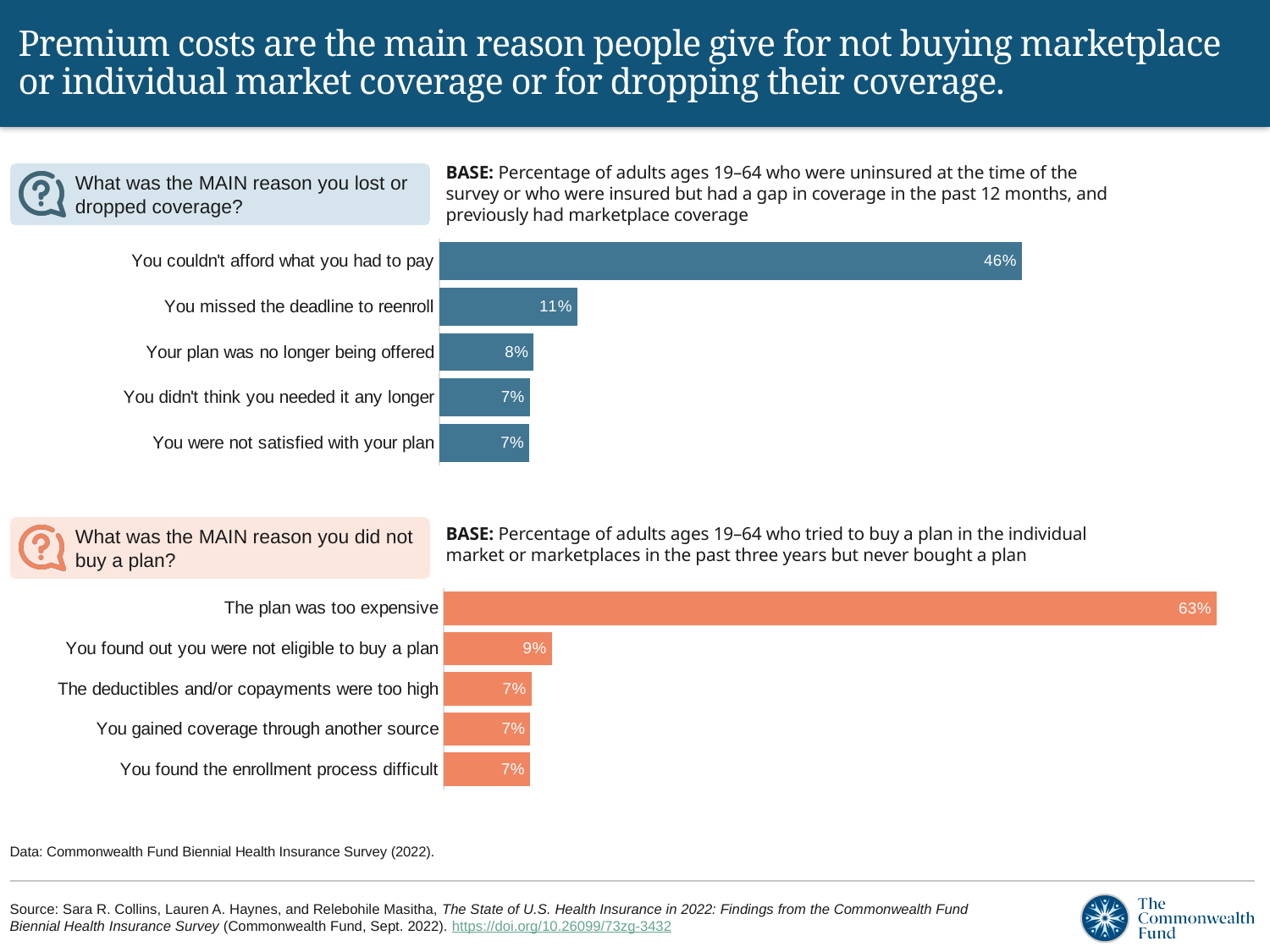
In the top chart (main reason you lost or dropped coverage), how many reasons are listed? 5 In the bottom chart (main reason you did not buy a plan), what percentage said they found out they were not eligible to buy a plan? 9% In the top chart (main reason you lost or dropped coverage), what is the difference between 'You couldn't afford what you had to pay' and 'You missed the deadline to reenroll'? 35 percentage points In the bottom chart (main reason you did not buy a plan), what is the difference between 'The plan was too expensive' and 'You found out you were not eligible to buy a plan'? 54 percentage points What type of chart is used on this slide? Bar chart In the top chart (main reason you lost or dropped coverage), what percentage said they missed the deadline to reenroll? 11% In the top chart (main reason you lost or dropped coverage), what percentage said they couldn't afford what they had to pay? 46% In the bottom chart (main reason you did not buy a plan), what percentage said the plan was too expensive? 63% In the top chart (main reason you lost or dropped coverage), which reason has the highest percentage? You couldn't afford what you had to pay What colour are the bars in the bottom chart (main reason you did not buy a plan)? Orange In the bottom chart (main reason you did not buy a plan), which reason has the highest percentage? The plan was too expensive Which is larger: the top chart's value for 'You couldn't afford what you had to pay' or the bottom chart's value for 'The plan was too expensive'? The plan was too expensive